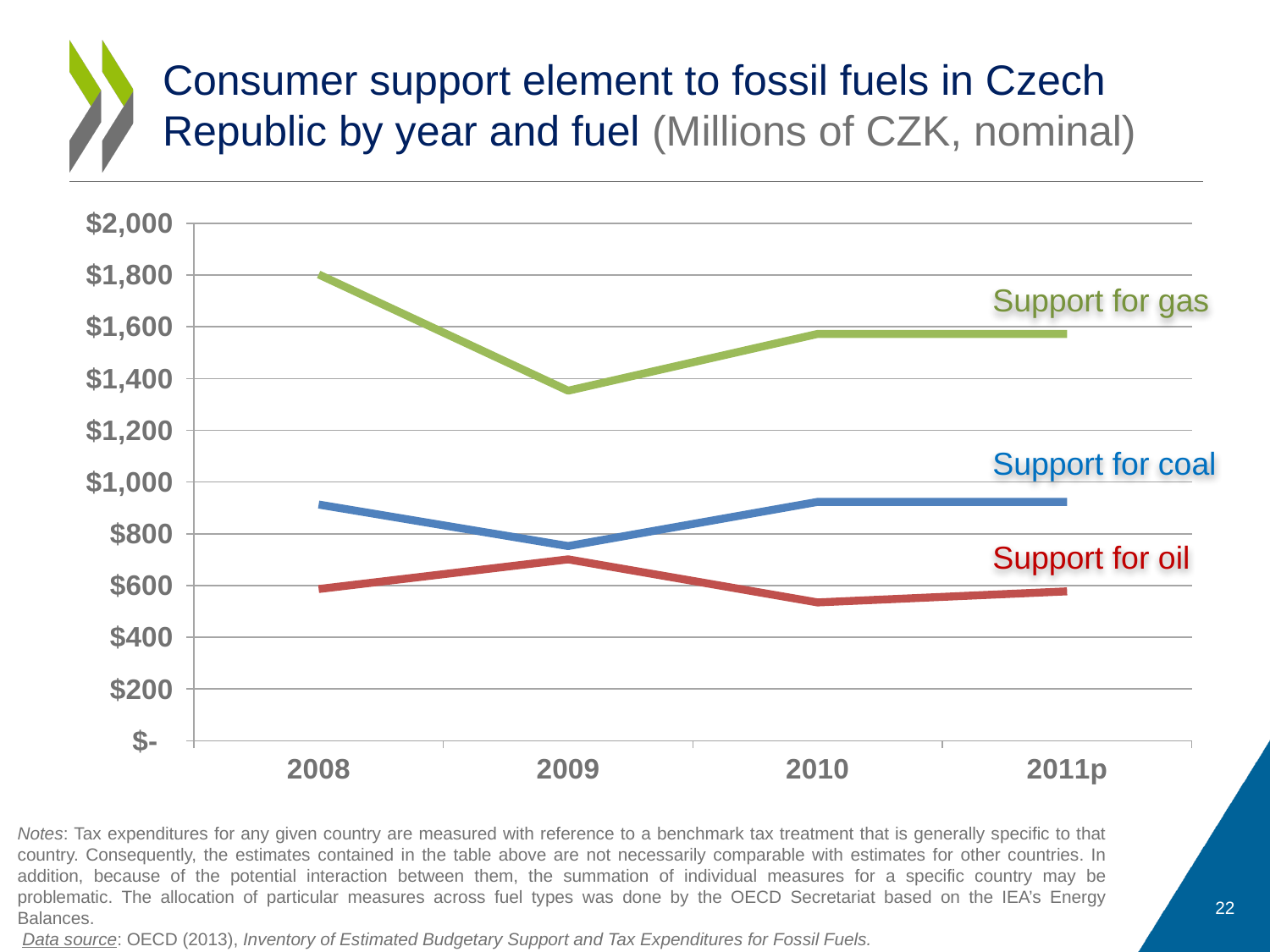
How many years are shown along the x axis? 4 In which year is support for gas at its lowest? 2009 How many series are plotted on the chart? 3 In 2008, which is larger: support for coal or support for oil? Support for coal Which fuel has the highest consumer support in every year shown? Support for gas What kind of chart is shown on the slide? Line chart In which year is support for coal at its lowest? 2009 In which year is support for oil at its highest? 2009 Is the value for support for coal in 2009 greater or less than $800? less Is the value for support for oil in 2010 greater or less than $600? less Is the value for support for gas in 2008 greater or less than $1,600? greater Does support for gas rise or fall from 2008 to 2009? Fall